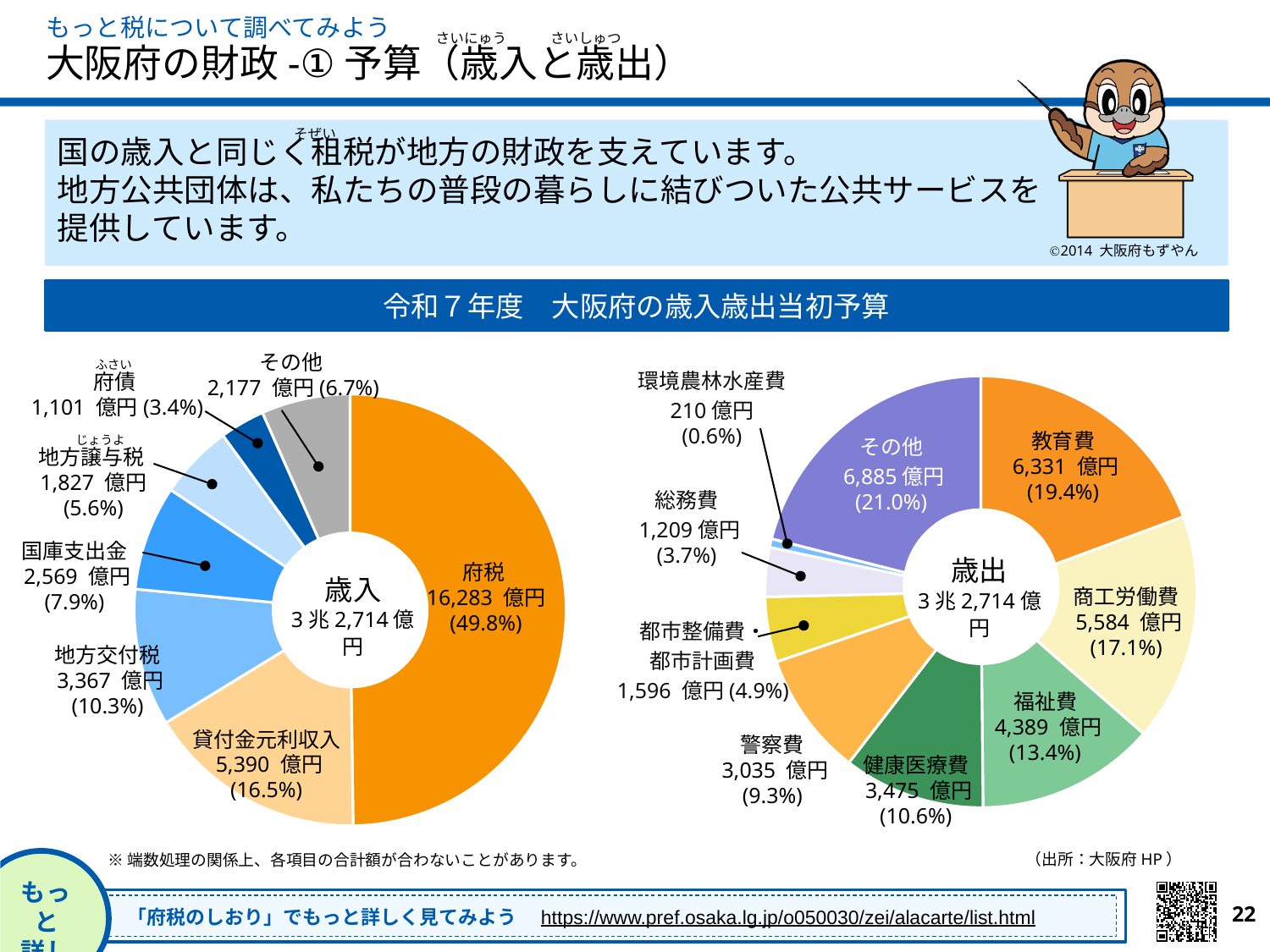
In the 歳入 (revenue) chart on the left, what is the value for 府税? 16,283 億円 In the 歳出 chart on the right, which named category (excluding その他) is the largest? 教育費 In the 歳入 chart on the left, what share of the total does 貸付金元利収入 account for? 16.5% In the 歳入 chart on the left, how many categories are shown? 7 What type of chart is used for both 歳入 and 歳出 on this slide? Pie (donut) chart In the 歳出 chart on the right, how many categories are shown? 9 In the 歳入 chart on the left, which category is the smallest? 府債 In the 歳出 chart on the right, which is larger, 福祉費 or 健康医療費? 福祉費 In the 歳出 chart on the right, what percentage share does 警察費 have? 9.3% In the 歳出 chart on the right, which category is the smallest? 環境農林水産費 In the 歳入 chart on the left, what is the difference between 地方交付税 and 国庫支出金 in 億円? 798 億円 In the 歳出 (expenditure) chart on the right, what is the value for 教育費? 6,331 億円